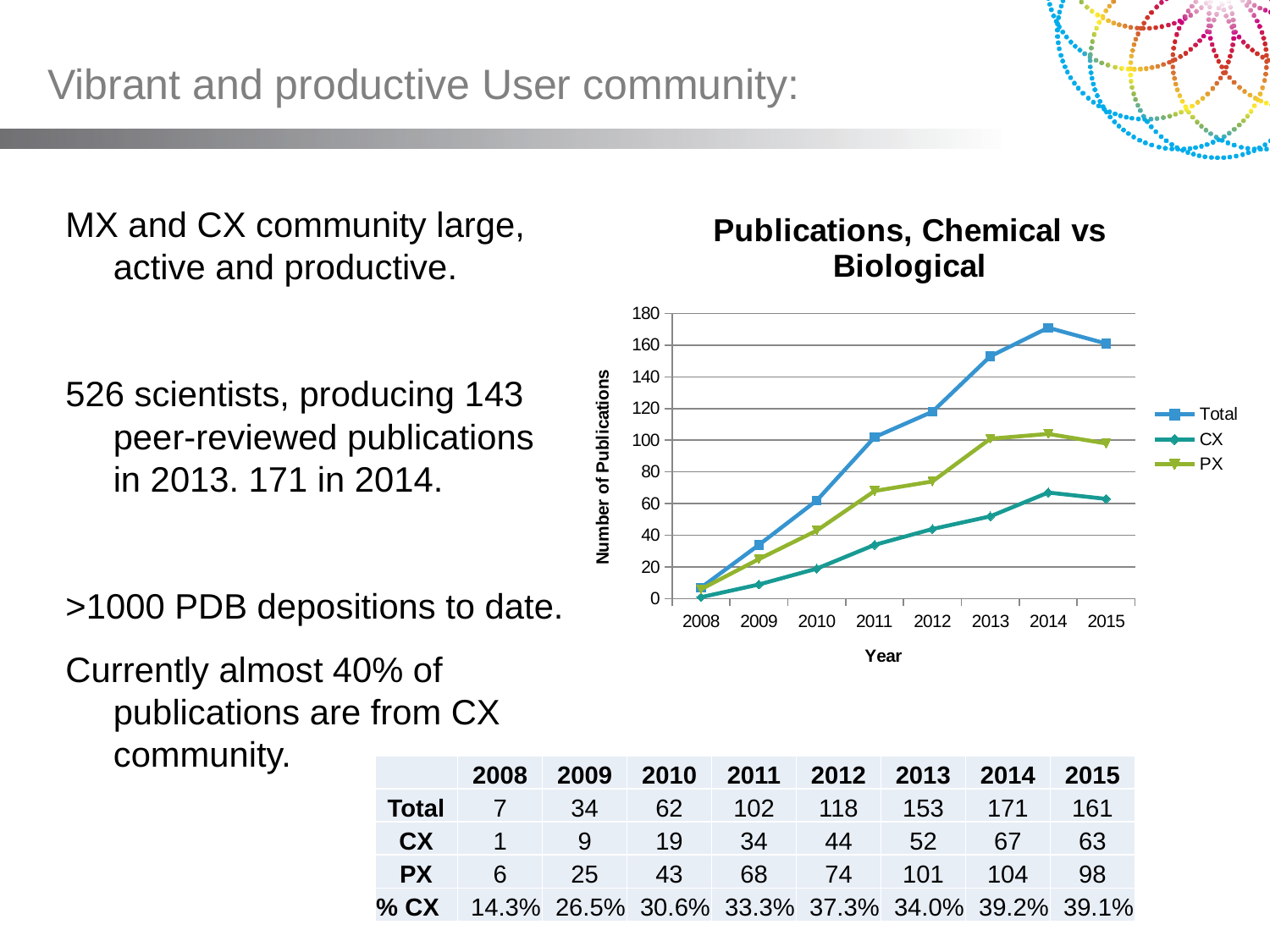
What is the CX value for 2011? 34 In which year is the CX series at its lowest? 2008 Does the Total series rise or fall from 2008 to 2014? rise What is the PX value for 2013? 101 What is the title of the chart? Publications, Chemical vs Biological What kind of chart is shown on the slide? line chart Which is larger in 2012, the PX value or the CX value? PX In which year is the Total series at its highest? 2014 How many series does the chart legend list? 3 How many years are plotted along the x axis of the chart? 8 What is the difference between the PX and CX values in 2015? 35 What is the Total number of publications in 2014? 171